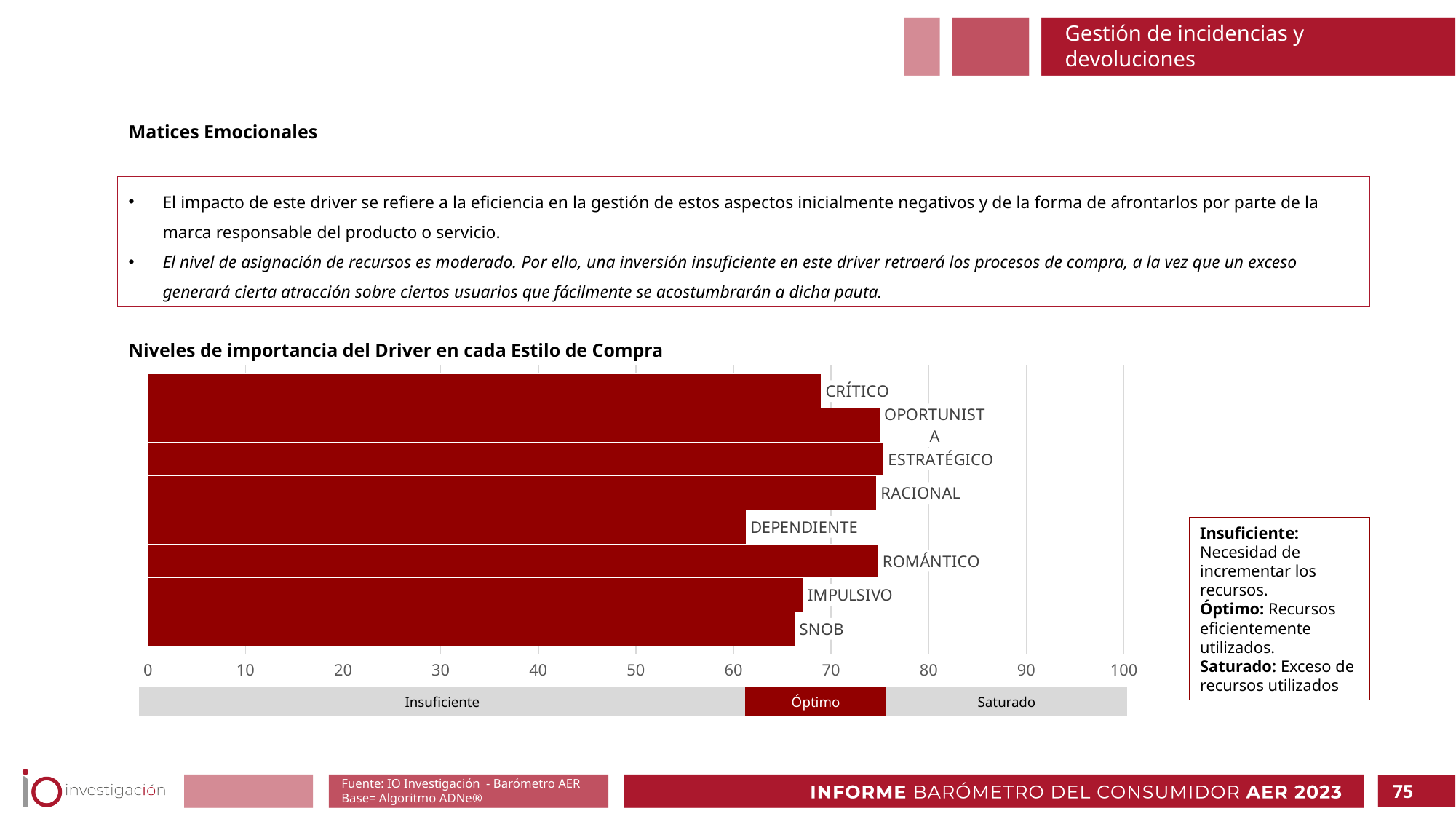
Is the value for SNOB greater or less than 70? less What kind of chart is shown under 'Niveles de importancia del Driver en cada Estilo de Compra'? bar chart Which has the larger value, SNOB or ROMÁNTICO? ROMÁNTICO How many purchase styles (categories) are plotted in the bar chart? 8 Which of the three zones shown below the x axis is highlighted in dark red? Óptimo Is the value for ESTRATÉGICO greater or less than 70? greater Is the value for DEPENDIENTE greater or less than 50? greater Which purchase style has the lowest value in the bar chart? DEPENDIENTE What is the title of the bar chart? Niveles de importancia del Driver en cada Estilo de Compra Which has the larger value, DEPENDIENTE or ESTRATÉGICO? ESTRATÉGICO